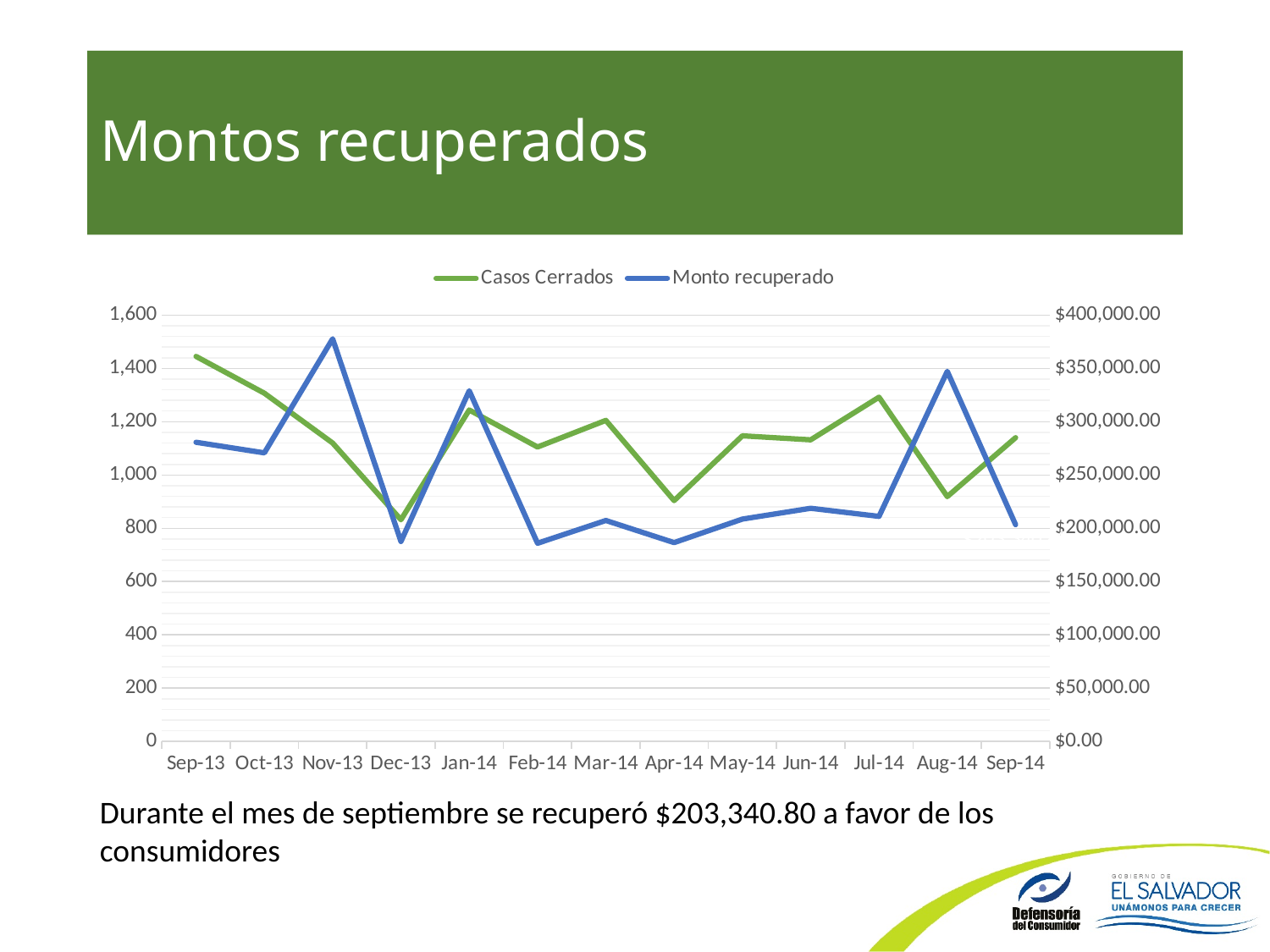
In which month is Casos Cerrados highest? Sep-13 Is the value of Monto recuperado for Feb-14 greater or less than $200,000.00? less How many months are plotted along the x axis? 13 What kind of chart is shown on the slide? line chart Which series is drawn in blue? Monto recuperado Is the value of Casos Cerrados for Dec-13 greater or less than 1,000? less In which month is Monto recuperado highest? Nov-13 How many series does the legend list? 2 What is the title of the slide containing the chart? Montos recuperados Does Casos Cerrados rise or fall from Sep-13 to Dec-13? fall In which month is Casos Cerrados lowest? Dec-13 Is the value of Monto recuperado for Nov-13 greater or less than $350,000.00? greater